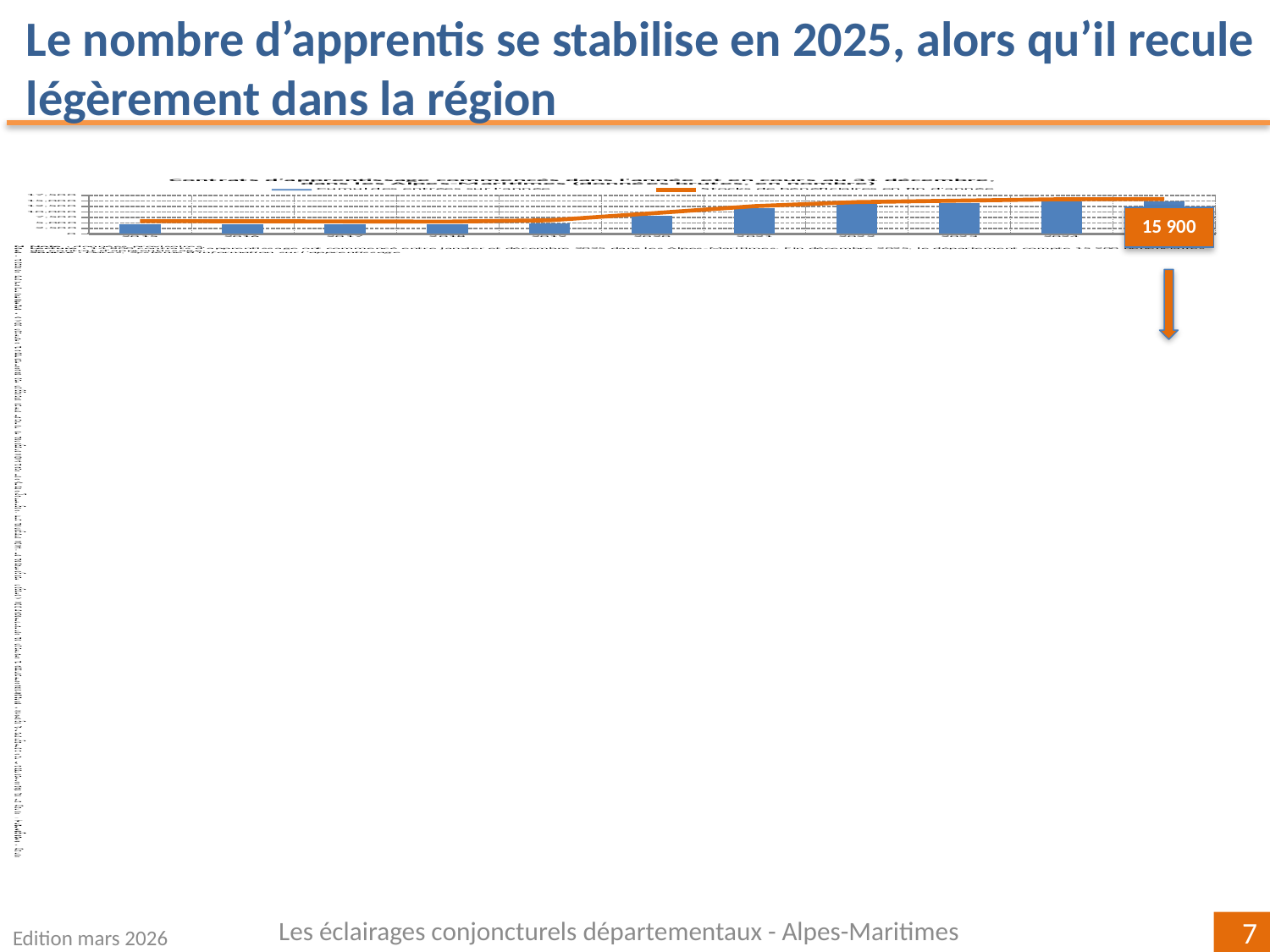
How many series does the chart's legend list? 2 What value is printed in the orange callout box at the right end of the chart? 15 900 What colour are the bars in the chart? Blue How many bars are plotted in the chart? 11 What kind of chart is shown on the slide? A bar chart combined with a line Does the orange line rise or fall overall from left to right across the chart? Rise Do the blue bars generally rise or fall from left to right across the chart? Rise